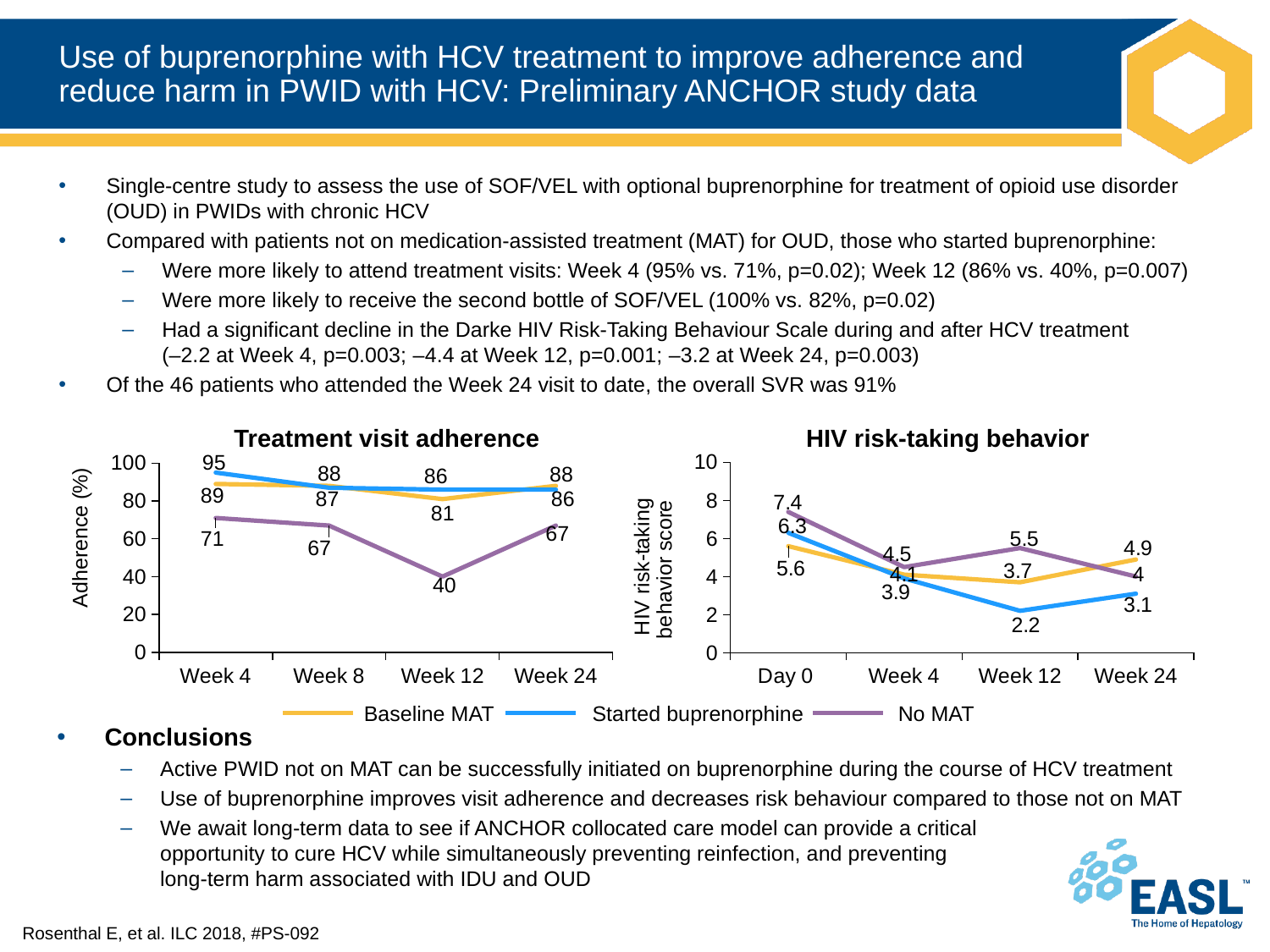
In the Treatment visit adherence chart, what is the difference between Started buprenorphine and No MAT at Week 12? 46 In the HIV risk-taking behavior chart, which is larger at Week 24: Baseline MAT or Started buprenorphine? Baseline MAT In the HIV risk-taking behavior chart, which series has the highest score at Week 12? No MAT In the Treatment visit adherence chart, what is the adherence for No MAT at Week 12? 40 In the HIV risk-taking behavior chart, does the Started buprenorphine score rise or fall from Day 0 to Week 12? fall In the HIV risk-taking behavior chart, what is the score for No MAT at Day 0? 7.4 In the Treatment visit adherence chart, which series has the lowest adherence at Week 12? No MAT In the HIV risk-taking behavior chart, what is the score for Started buprenorphine at Week 12? 2.2 In the Treatment visit adherence chart, how many time points are shown on the x axis? 4 In the Treatment visit adherence chart, what is the adherence for Started buprenorphine at Week 4? 95 How many series does the legend list for the charts? 3 In the Treatment visit adherence chart, is the value for No MAT at Week 4 greater or less than 80? less